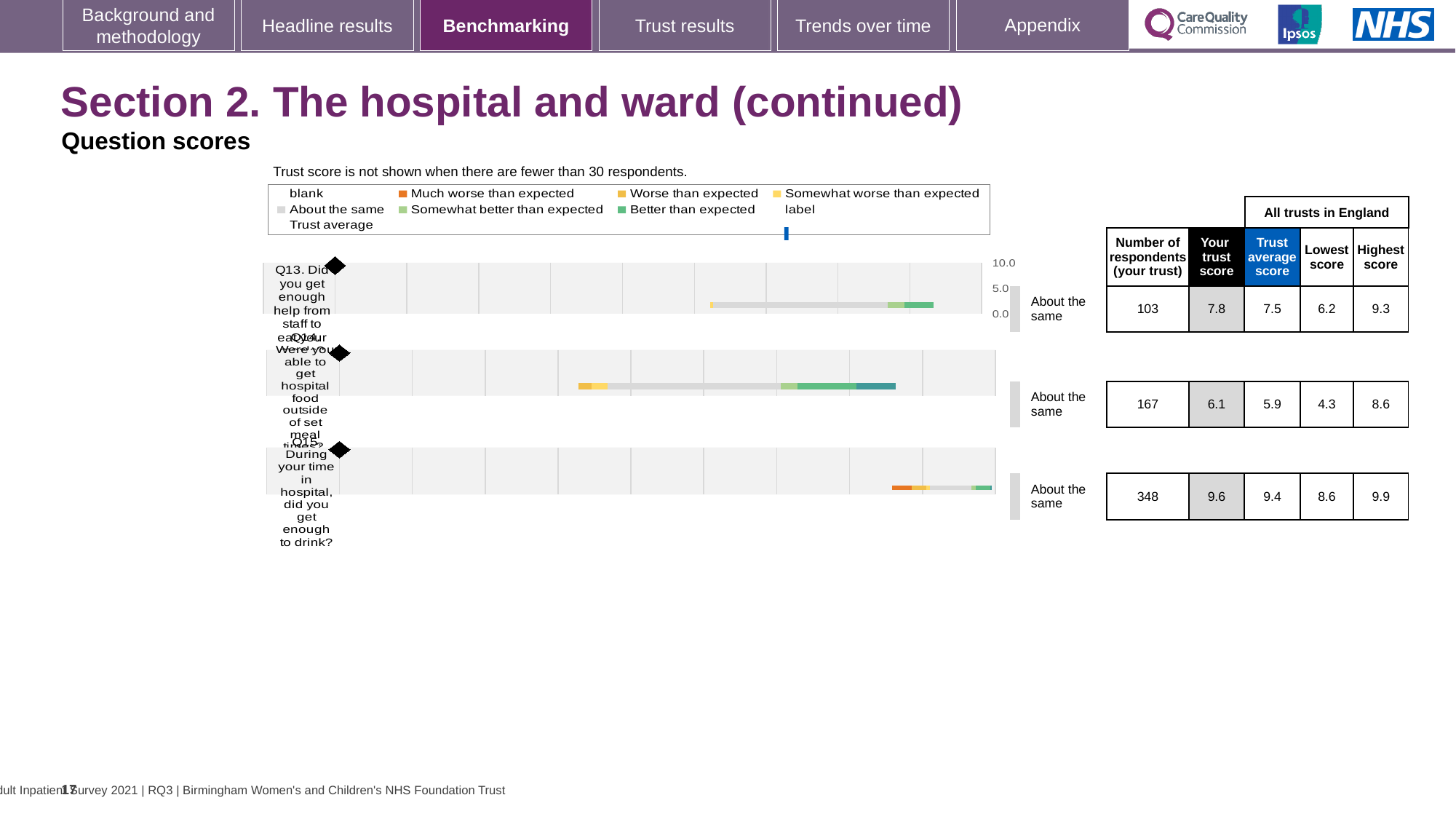
For Q14, which is larger: the 'Your trust score' or the trust average score? Your trust score What is the difference between the 'Your trust score' and the trust average score for Q13? 0.3 What kind of chart is used to show the question scores on this slide? bar chart What colour does the legend use for 'Much worse than expected'? orange How many respondents from your trust answered Q15 (did you get enough to drink?)? 348 How many questions (bars) are plotted in the chart? 3 What is the trust average score for Q14 (Were you able to get hospital food outside of set meal times?)? 5.9 Which of the three questions has the highest 'Your trust score'? Q15 What benchmark category is shown next to the Q13 bar? About the same What is the 'Your trust score' for Q13 (Did you get enough help from staff to eat your meals?)? 7.8 What is the highest value shown on the chart's score axis? 10.0 What is the lowest score across all trusts in England for Q14? 4.3